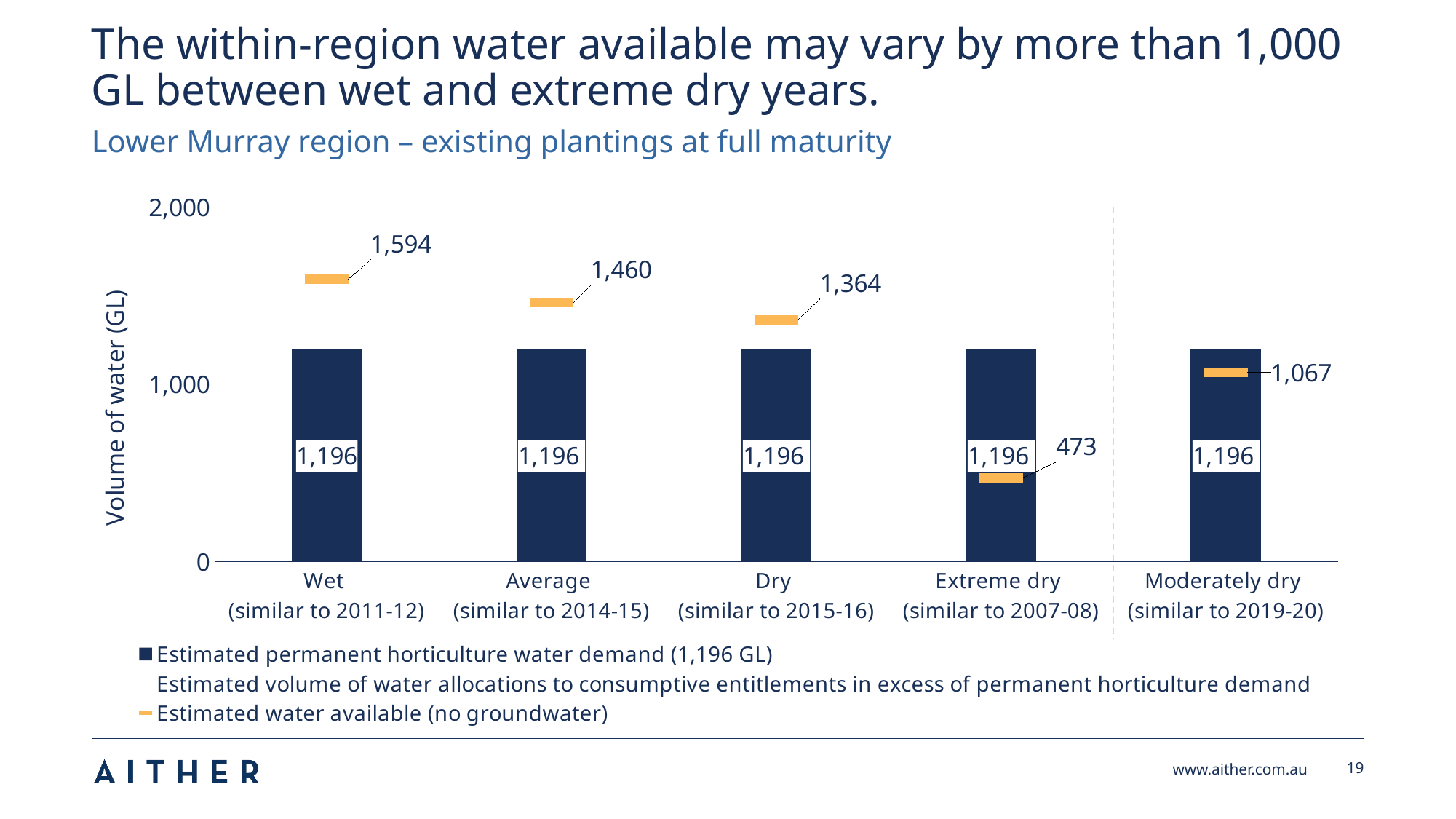
What is the difference in estimated water available between the Wet and Extreme dry scenarios? 1,121 What is the estimated permanent horticulture water demand shown for the Dry scenario? 1,196 How many scenarios are shown on the x axis? 5 What kind of chart is shown on the slide? Bar chart What is the estimated water available (no groundwater) for the Moderately dry scenario? 1,067 Which scenario has the lowest estimated water available (no groundwater)? Extreme dry What is the estimated water available (no groundwater) for the Wet scenario? 1,594 Is the estimated water available for the Average scenario greater or less than the estimated permanent horticulture water demand? greater How many series does the legend list? 3 What is the estimated water available (no groundwater) for the Extreme dry scenario? 473 Which scenario has the highest estimated water available (no groundwater)? Wet What is the difference in estimated water available between the Average and Dry scenarios? 96